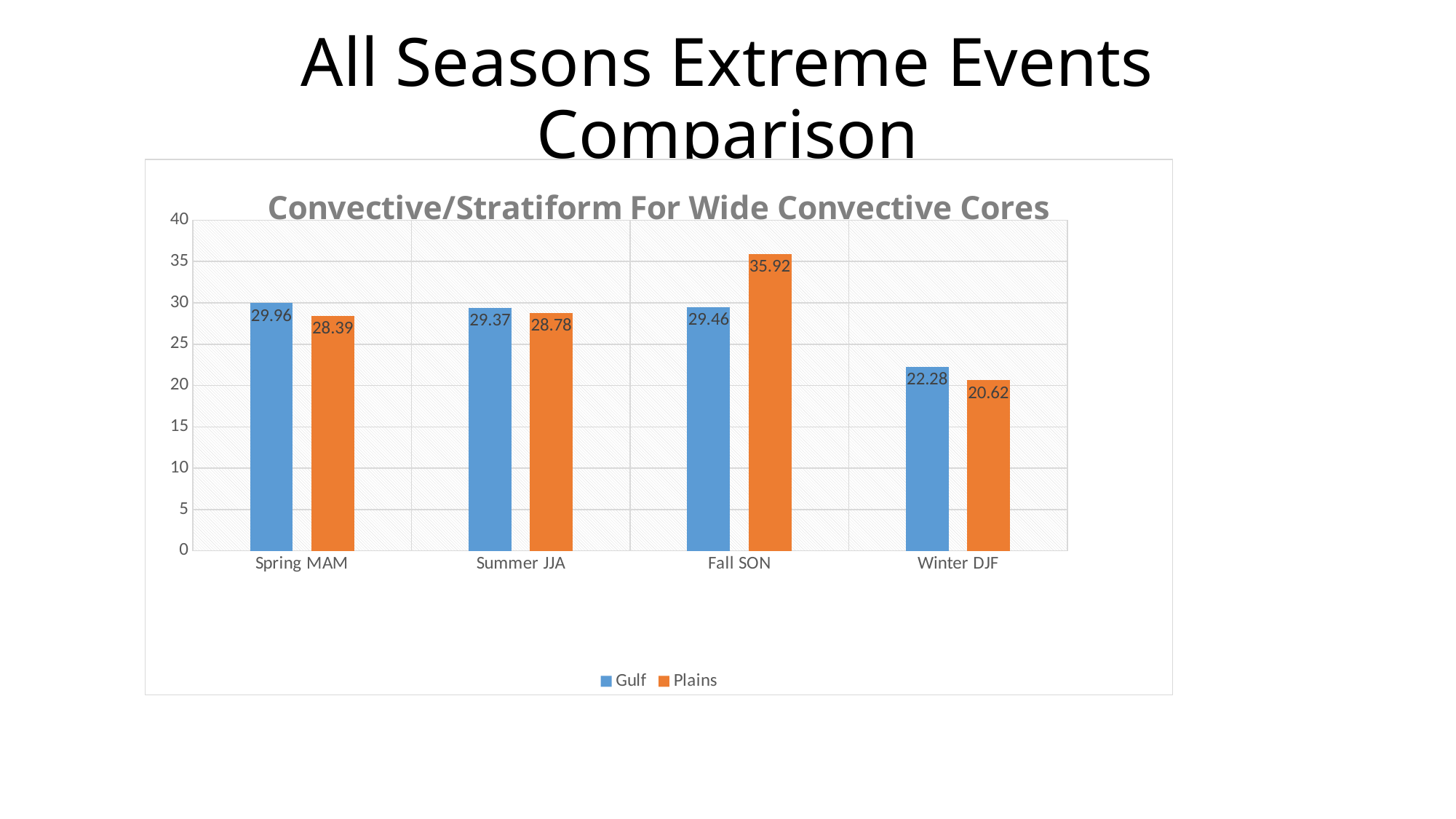
Which season has the lowest Gulf value? Winter DJF Is the Plains value for Fall SON greater or less than 35? greater How many series does the legend list? 2 What is the difference between the Plains and Gulf values for Fall SON? 6.46 What is the Gulf value for Spring MAM? 29.96 Which is larger for Winter DJF, the Gulf value or the Plains value? Gulf Which season has the highest Plains value? Fall SON What type of chart is shown? Bar chart What is the Gulf value for Summer JJA? 29.37 What is the Plains value for Fall SON? 35.92 How many seasons are shown on the x axis? 4 What is the Plains value for Winter DJF? 20.62